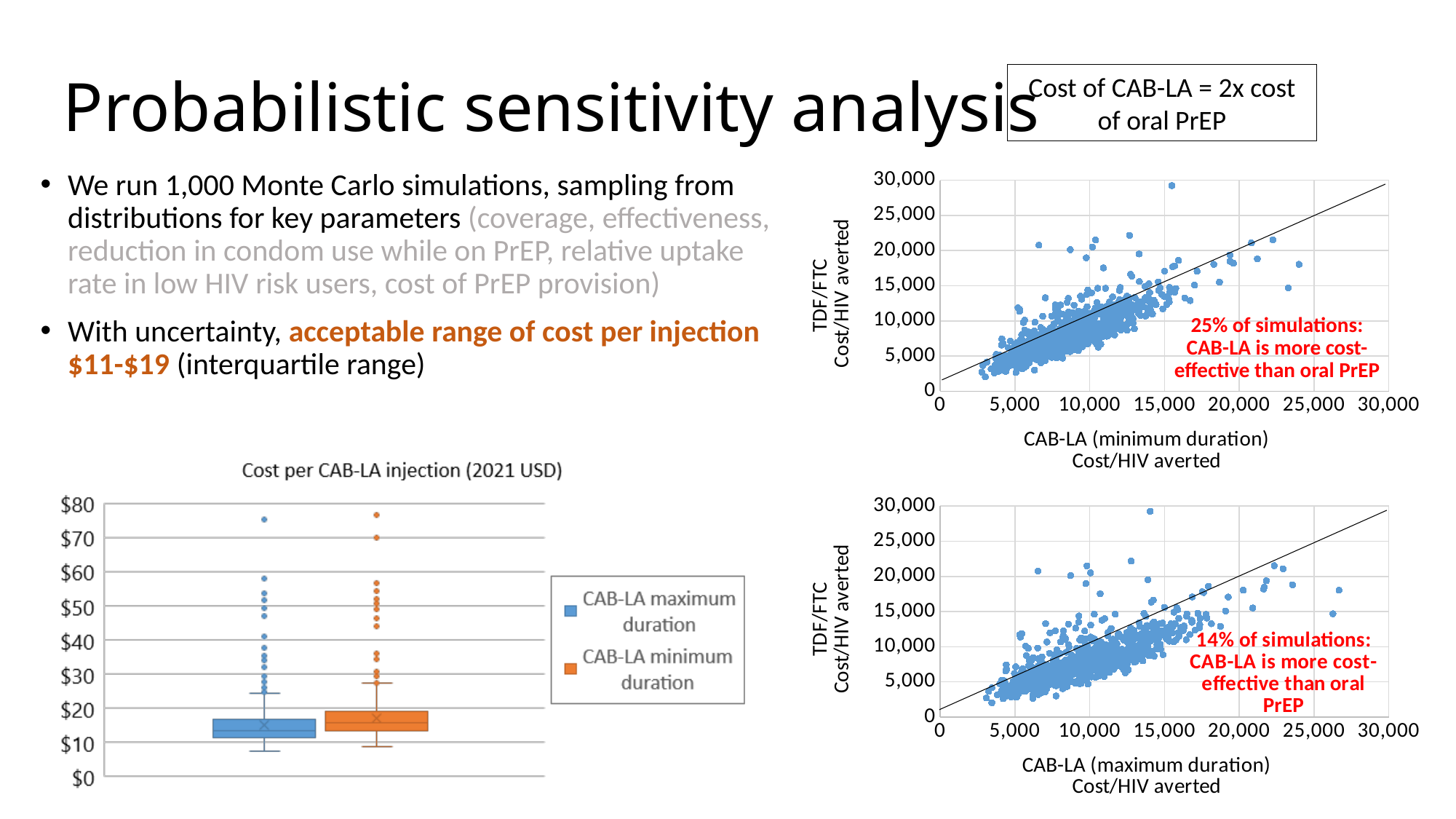
What kind of chart is the 'Cost per CAB-LA injection (2021 USD)' chart at the bottom left? Box plot What is the maximum value shown on the x axis of the bottom-right scatter plot? 30,000 Which scatter plot reports a larger share of simulations where CAB-LA is more cost-effective than oral PrEP, the minimum duration (top) or the maximum duration (bottom)? Minimum duration (top) In the 'Cost per CAB-LA injection (2021 USD)' chart, is the lowest whisker value for CAB-LA maximum duration greater or less than $10? less In the 'Cost per CAB-LA injection (2021 USD)' chart, which series is shown in orange? CAB-LA minimum duration In the top-right scatter plot (CAB-LA minimum duration), what percentage of simulations show CAB-LA is more cost-effective than oral PrEP? 25% In the bottom-right scatter plot (CAB-LA maximum duration), what percentage of simulations show CAB-LA is more cost-effective than oral PrEP? 14% In the 'Cost per CAB-LA injection (2021 USD)' chart, is the median for CAB-LA maximum duration greater or less than $20? less What is the y-axis label of the top-right scatter plot? TDF/FTC Cost/HIV averted How many series does the legend of the 'Cost per CAB-LA injection (2021 USD)' chart list? 2 What kind of chart is the top-right chart with x axis 'CAB-LA (minimum duration) Cost/HIV averted'? Scatter plot In the 'Cost per CAB-LA injection (2021 USD)' chart, is the highest outlier for CAB-LA minimum duration greater or less than $70? greater